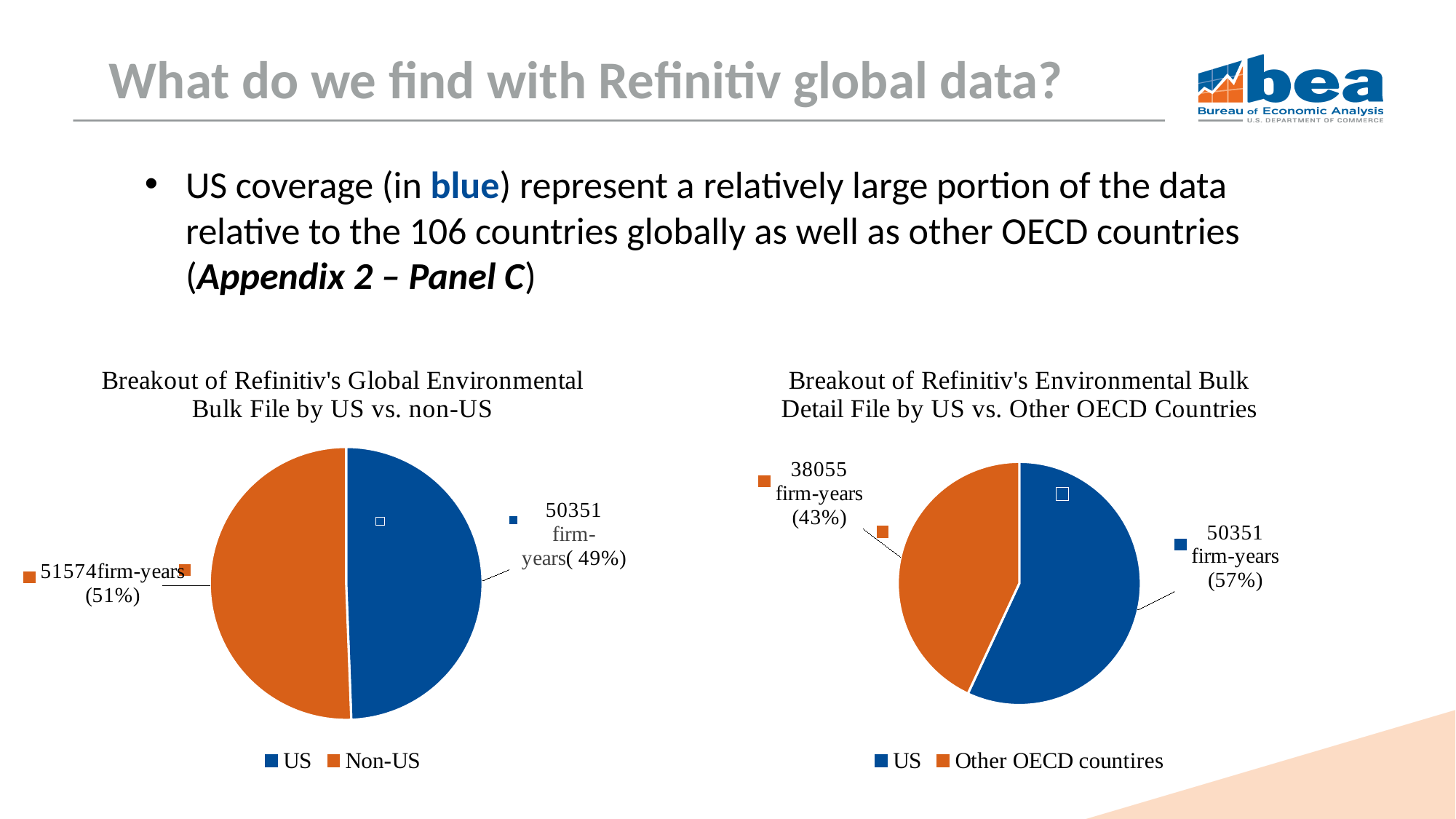
How many slices does the left pie chart (US vs. non-US) have? 2 What colour represents the US in both pie charts? blue In the right pie chart (US vs. Other OECD Countries), which category has the smaller slice? Other OECD countires In the right pie chart (US vs. Other OECD Countries), what share of the pie is the US slice? 57% In the left pie chart (US vs. non-US), what share of the pie is the Non-US slice? 51% In the left pie chart (US vs. non-US), which category has the larger slice? Non-US In the right pie chart (US vs. Other OECD Countries), how many firm-years does the Other OECD countries slice represent? 38055 firm-years In the left pie chart (US vs. non-US), how many firm-years does the US slice represent? 50351 firm-years In the right pie chart (US vs. Other OECD Countries), is the US slice larger or smaller than the Other OECD countries slice? larger In the right pie chart (US vs. Other OECD Countries), what is the difference in firm-years between US and Other OECD countries? 12296 What type of chart is used on the right side of the slide? pie chart In the left pie chart (US vs. non-US), what is the difference in firm-years between Non-US and US? 1223